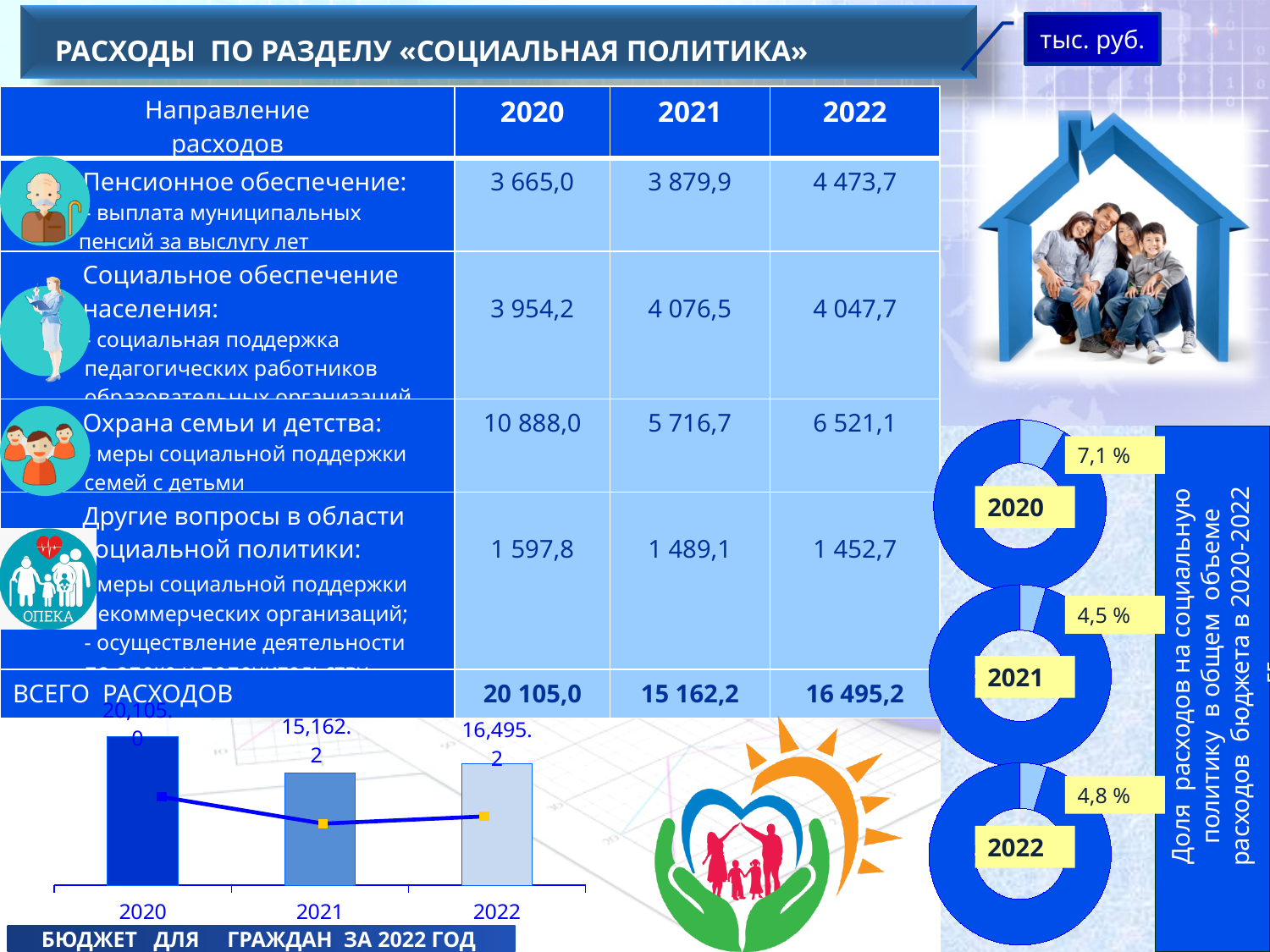
On the bar chart at the bottom left, what is the difference between the values for 2022 and 2021? 1,333.0 What kind of chart is shown at the bottom left of the slide? bar chart On the donut charts on the right, what share is shown for 2022? 4,8 % On the bar chart at the bottom left, what is the value for 2022? 16,495.2 On the donut charts on the right, what share is shown for 2020? 7,1 % On the bar chart at the bottom left, which is larger: the value for 2021 or the value for 2022? 2022 On the bar chart at the bottom left, which year has the lowest bar? 2021 Among the donut charts on the right, which year has the highest share? 2020 On the bar chart at the bottom left, which year has the highest bar? 2020 How many years are shown on the bar chart at the bottom left? 3 On the donut charts on the right, what share is shown for 2021? 4,5 % On the bar chart at the bottom left, what is the value for 2021? 15,162.2